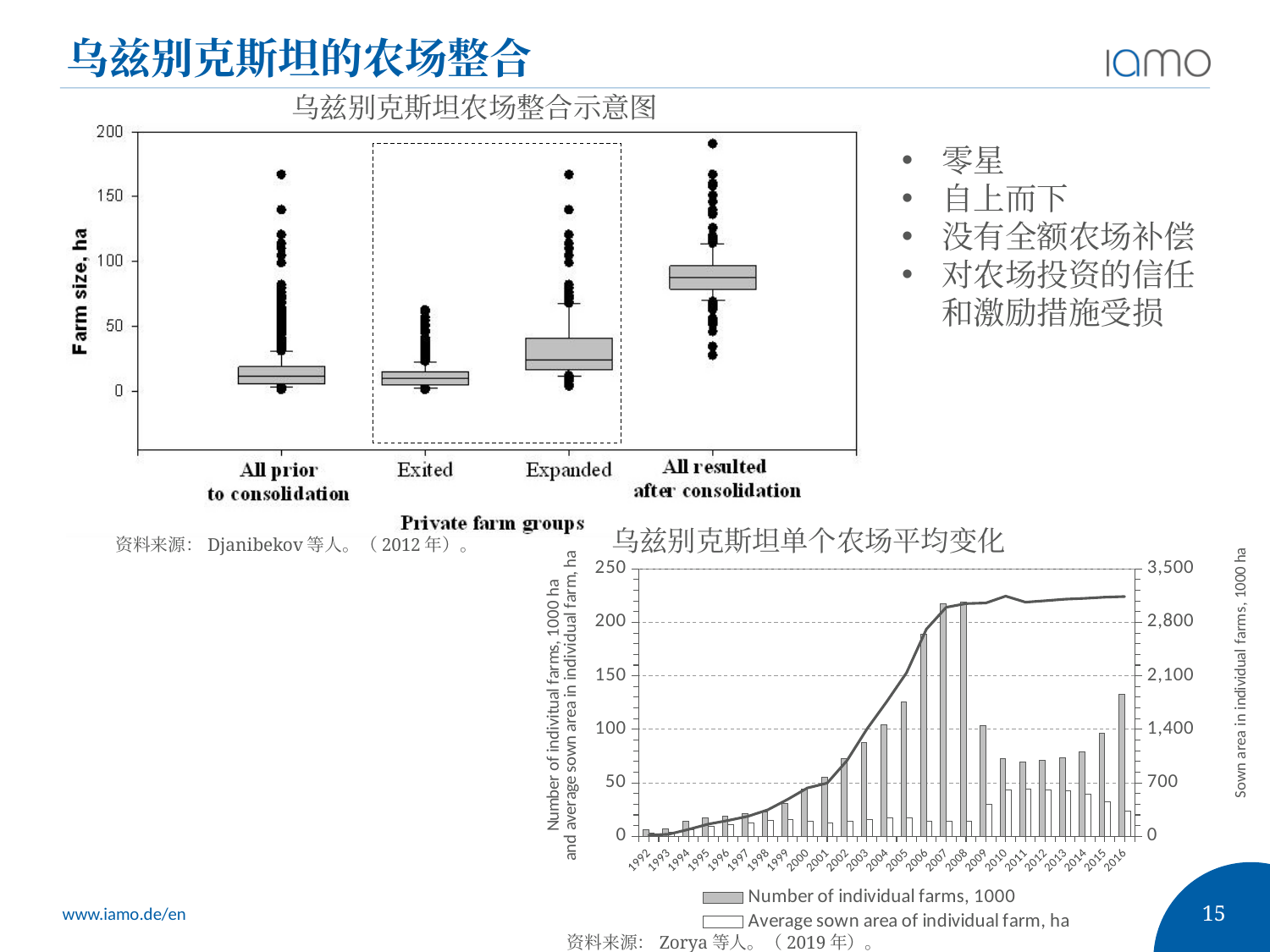
In the chart titled 乌兹别克斯坦农场整合示意图, what is the label of the y axis? Farm size, ha In the chart titled 乌兹别克斯坦农场整合示意图, how many private farm groups are shown on the x axis? 4 In the chart titled 乌兹别克斯坦单个农场平均变化, is the Number of individual farms, 1000 in 2010 greater or less than 100? less In the chart titled 乌兹别克斯坦农场整合示意图, is the median farm size for All resulted after consolidation greater or less than 50? greater What kind of chart is the chart titled 乌兹别克斯坦农场整合示意图? box plot In the chart titled 乌兹别克斯坦单个农场平均变化, does the line for sown area in individual farms generally rise or fall from 1992 to 2016? rise In the chart titled 乌兹别克斯坦单个农场平均变化, which year has the lowest Number of individual farms, 1000? 1992 In the chart titled 乌兹别克斯坦单个农场平均变化, how many entries does the legend list? 2 In the chart titled 乌兹别克斯坦单个农场平均变化, is the Number of individual farms, 1000 in 2008 greater or less than 200? greater In the chart titled 乌兹别克斯坦单个农场平均变化, is the Number of individual farms, 1000 larger in 2006 or in 2009? 2006 In the chart titled 乌兹别克斯坦农场整合示意图, which farm group has the highest median farm size? All resulted after consolidation In the chart titled 乌兹别克斯坦单个农场平均变化, how many years are shown on the x axis? 25